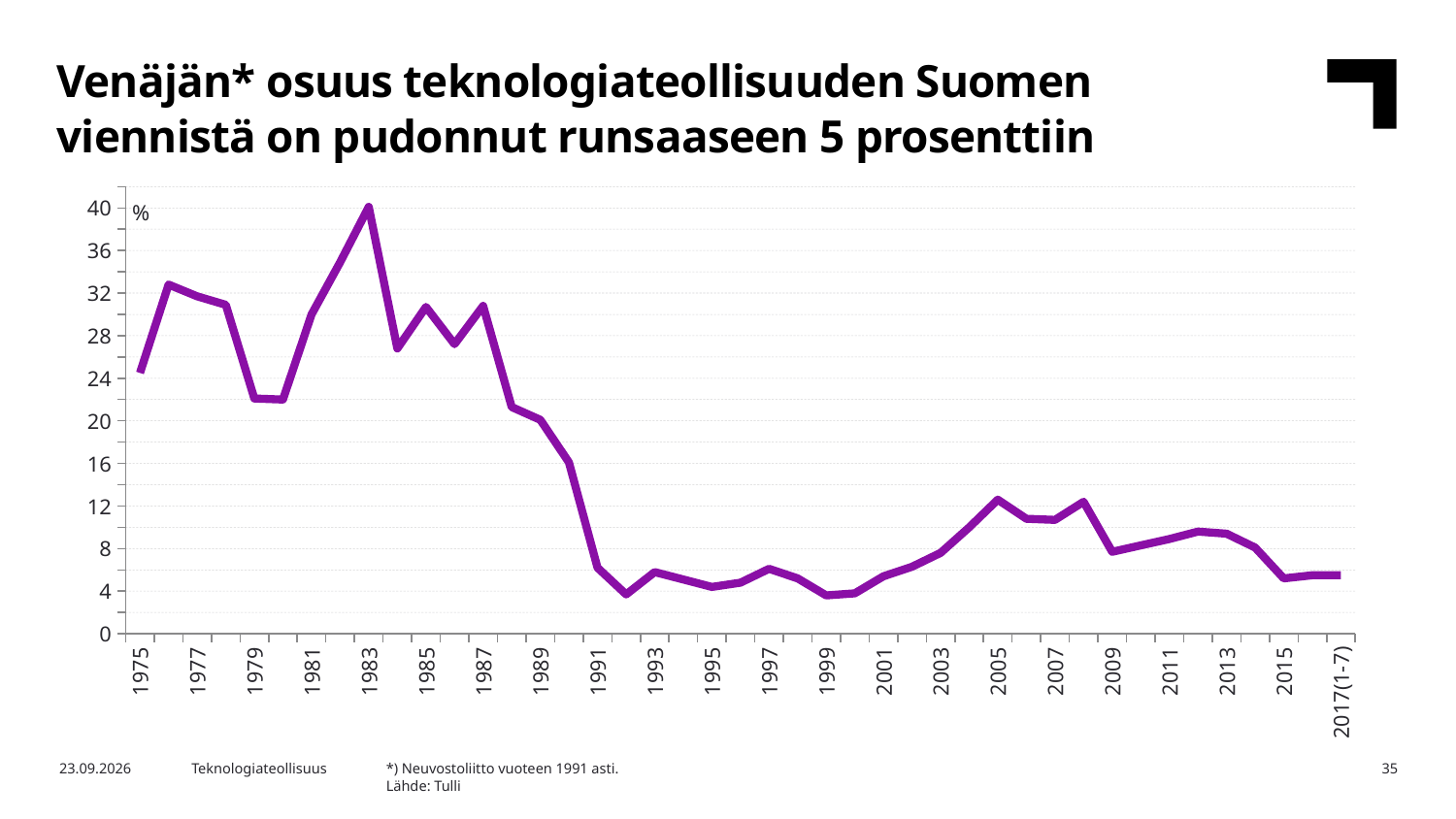
Is the value for 1992 greater or less than 8? less Is the value for 2017(1-7) greater or less than 8? less What colour is the plotted line? purple Is the value for 2005 greater or less than 16? less Does the line rise or fall between 1983 and 1992? fall What kind of chart is shown on the slide? line chart What unit is shown at the top of the y axis? % Which year has the larger value, 1983 or 2005? 1983 In which year does the line reach its highest value? 1983 Which year has the larger value, 1977 or 1979? 1977